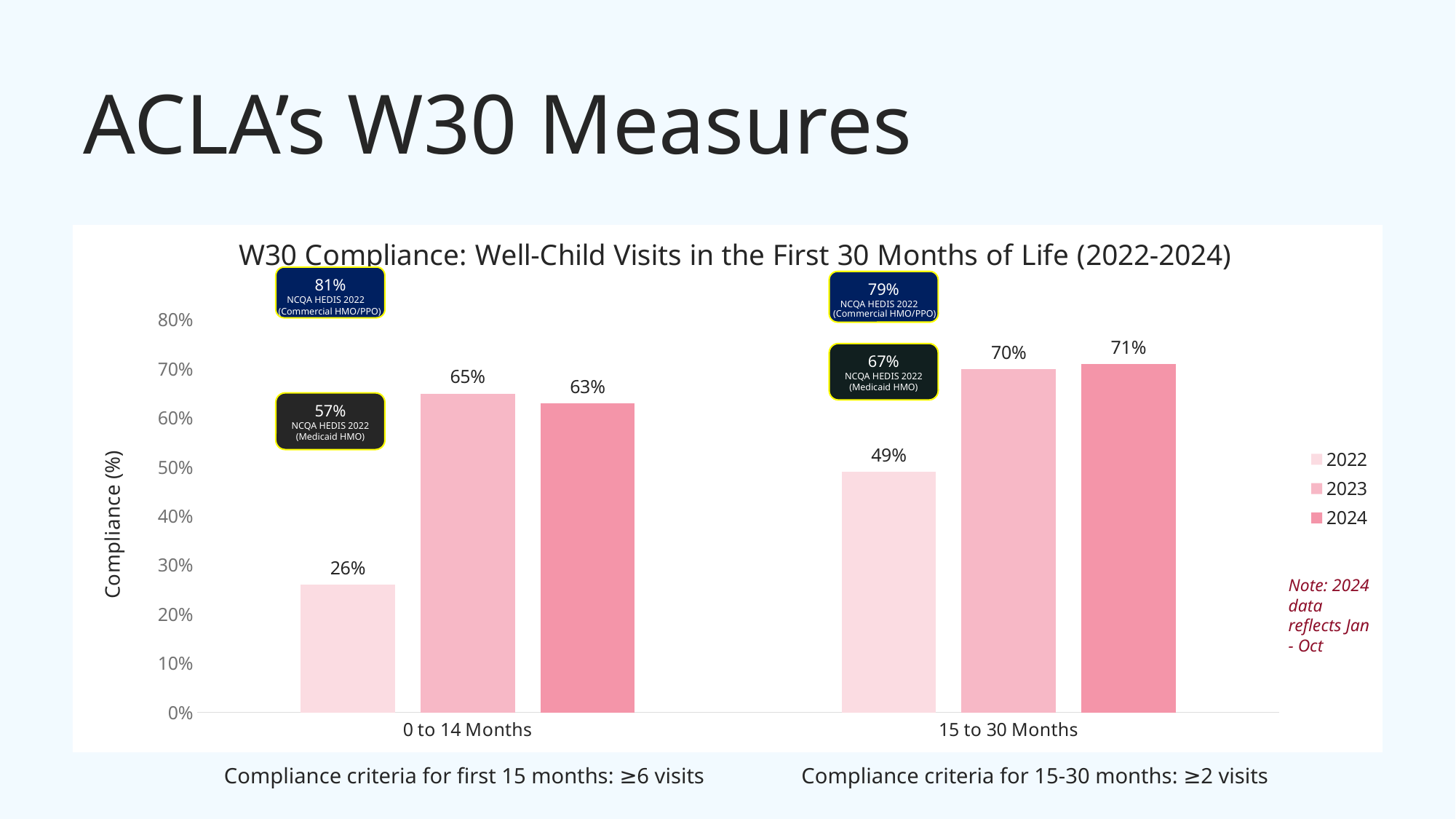
What is the 2022 compliance value for 0 to 14 Months? 26% What is the difference between the 2024 and 2022 compliance values for 15 to 30 Months? 22% What is the 2024 compliance value for 15 to 30 Months? 71% Which year has the lowest compliance value for 15 to 30 Months? 2022 What is the title of the chart? W30 Compliance: Well-Child Visits in the First 30 Months of Life (2022-2024) What is the 2023 compliance value for 0 to 14 Months? 65% What kind of chart is shown on the slide? Bar chart How many categories are shown on the x axis? 2 Which year has the highest compliance value for 0 to 14 Months? 2023 Which is larger: the 2024 value for 0 to 14 Months or the 2024 value for 15 to 30 Months? 15 to 30 Months How many series does the legend list? 3 What is the difference between the 2023 and 2022 compliance values for 0 to 14 Months? 39%